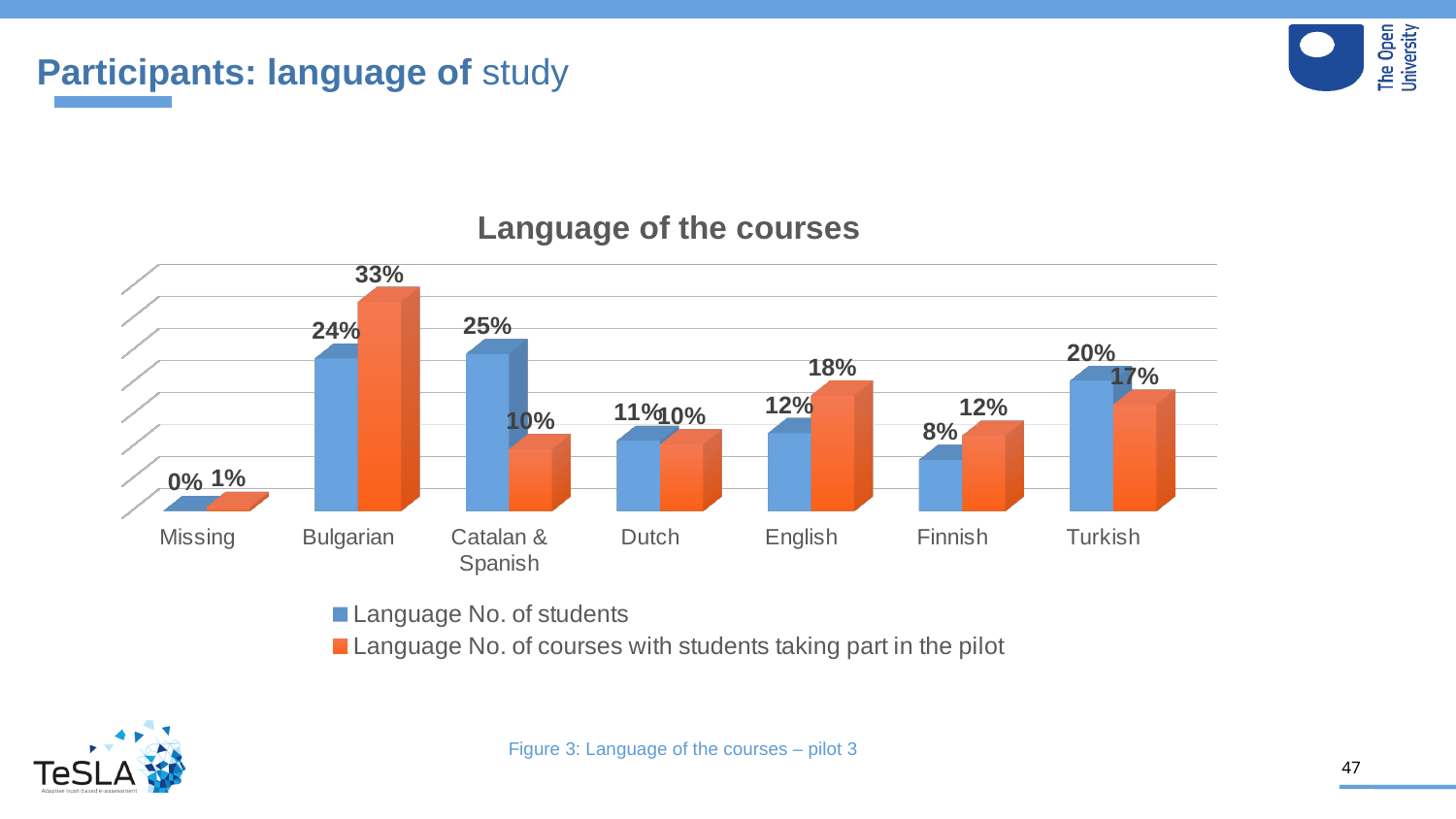
For Turkish, which series has the larger value: 'Language No. of students' or 'Language No. of courses with students taking part in the pilot'? Language No. of students What is the value for Turkish in the 'Language No. of courses with students taking part in the pilot' series? 17% What is the value for Finnish in the 'Language No. of students' series? 8% What kind of chart is shown on the slide? Bar chart How many series does the legend list? 2 How many language categories are shown on the x axis? 7 Which category has the lowest value in the 'Language No. of courses with students taking part in the pilot' series? Missing What is the difference between the two series' values for English? 6% What is the value for Catalan & Spanish in the 'Language No. of students' series? 25% What is the value for Bulgarian in the 'Language No. of courses with students taking part in the pilot' series? 33% Which language has the highest value in the 'Language No. of students' series? Catalan & Spanish What is the title of the chart? Language of the courses